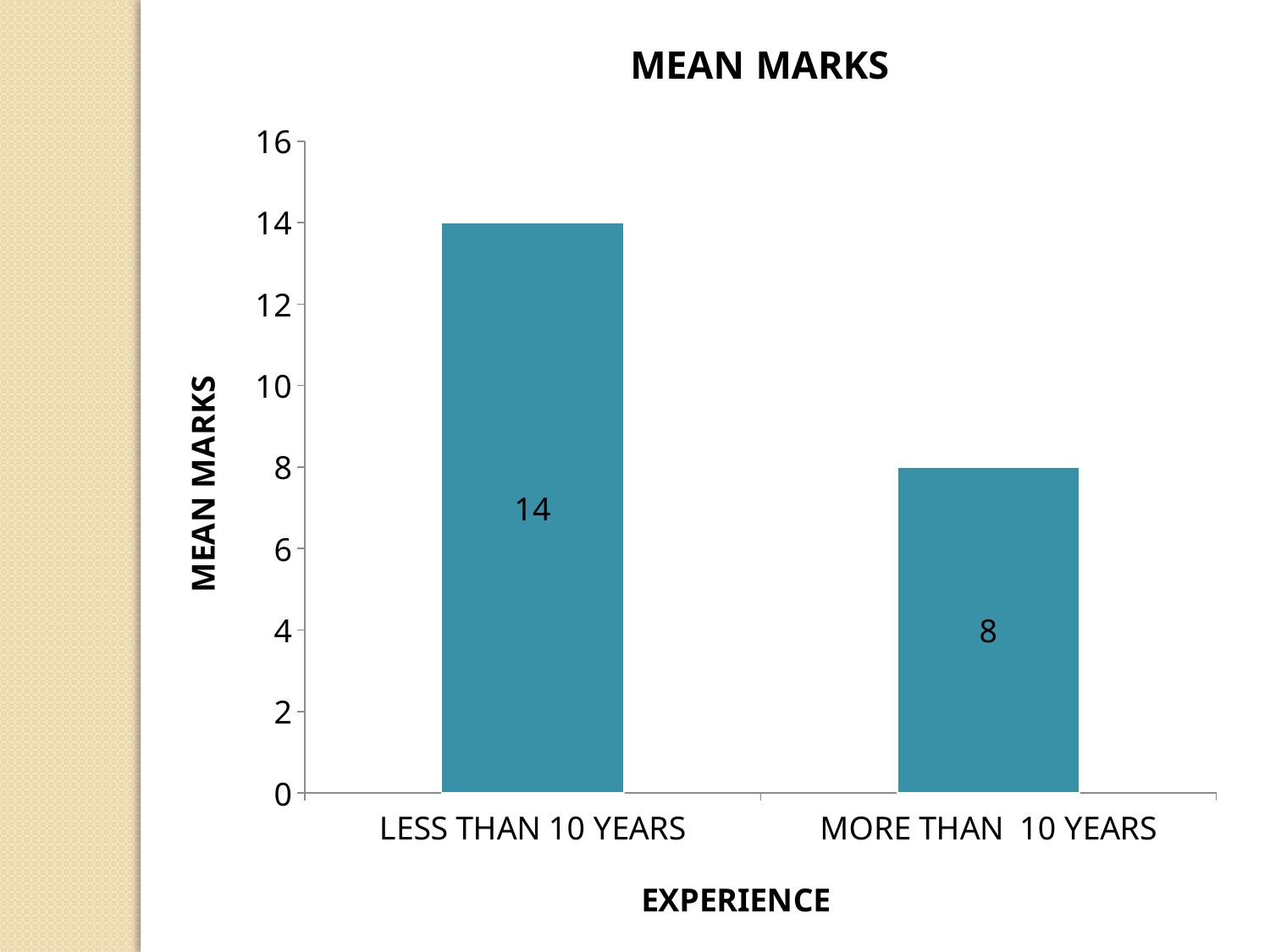
What is the title of the chart? MEAN MARKS Which experience category has the lowest mean marks? MORE THAN 10 YEARS What is the mean marks value for MORE THAN 10 YEARS? 8 What is the mean marks value for LESS THAN 10 YEARS? 14 What kind of chart is shown on the slide? bar chart How many experience categories are shown in the chart? 2 Which has higher mean marks, LESS THAN 10 YEARS or MORE THAN 10 YEARS? LESS THAN 10 YEARS Is the mean marks value for MORE THAN 10 YEARS greater or less than 10? less What is the label of the x axis? EXPERIENCE Which experience category has the highest mean marks? LESS THAN 10 YEARS Is the mean marks value for LESS THAN 10 YEARS greater or less than 12? greater What is the difference in mean marks between LESS THAN 10 YEARS and MORE THAN 10 YEARS? 6